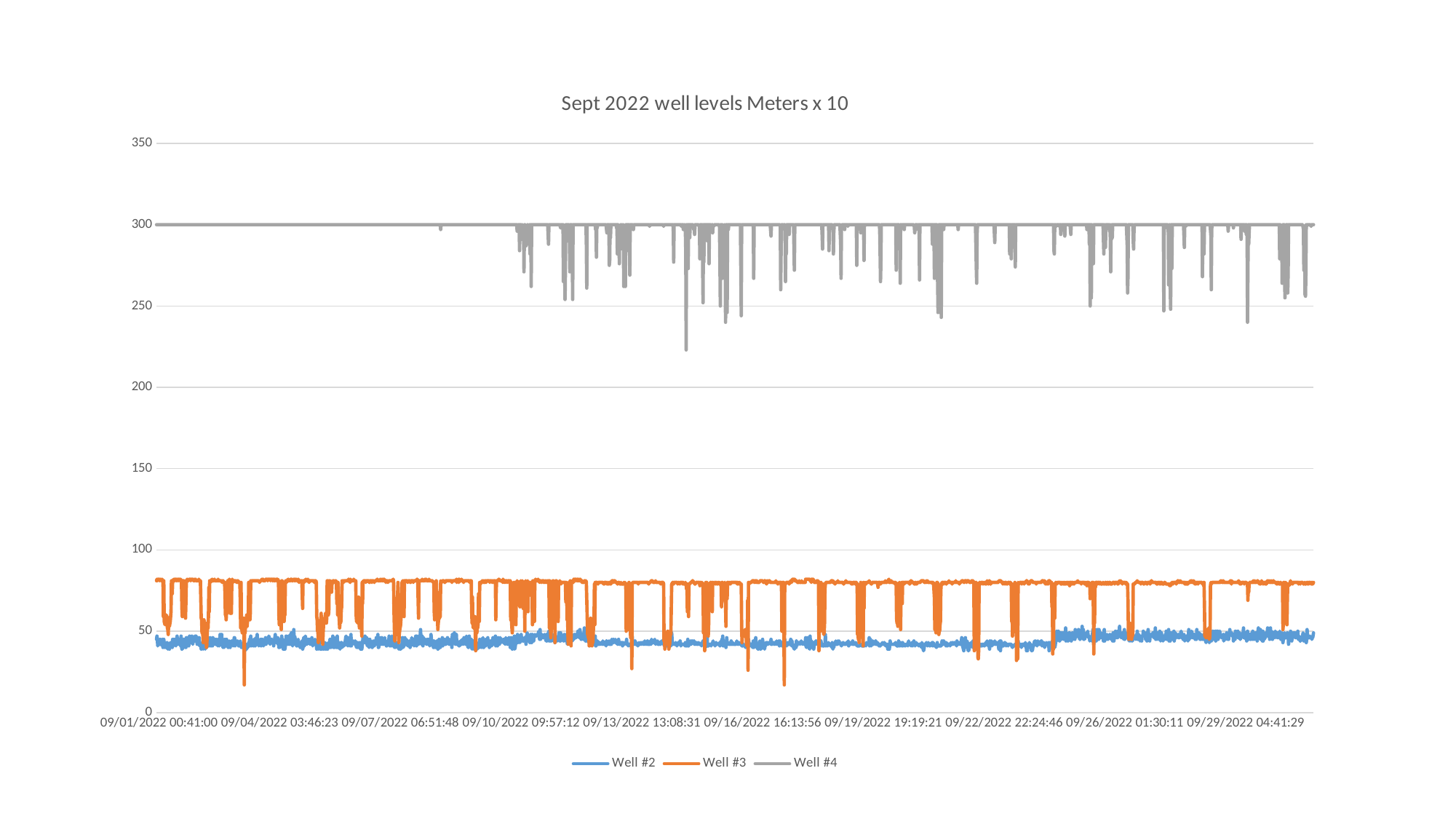
Which series has the higher level on 09/01/2022, Well #2 or Well #4? Well #4 Is the value for Well #4 on 09/01/2022 greater or less than 250? greater How many date labels are shown along the x axis? 10 Is the value for Well #3 on 09/01/2022 greater or less than 100? less What is the title of the chart? Sept 2022 well levels Meters x 10 How many series does the legend list? 3 Is the value for Well #2 on 09/01/2022 greater or less than 100? less Which series is plotted at the highest level throughout the month? Well #4 What colour is the Well #3 series drawn in? orange What kind of chart is shown on the slide? line chart Which series is plotted at the lowest level for most of the month? Well #2 Which series has the higher level on 09/01/2022, Well #2 or Well #3? Well #3